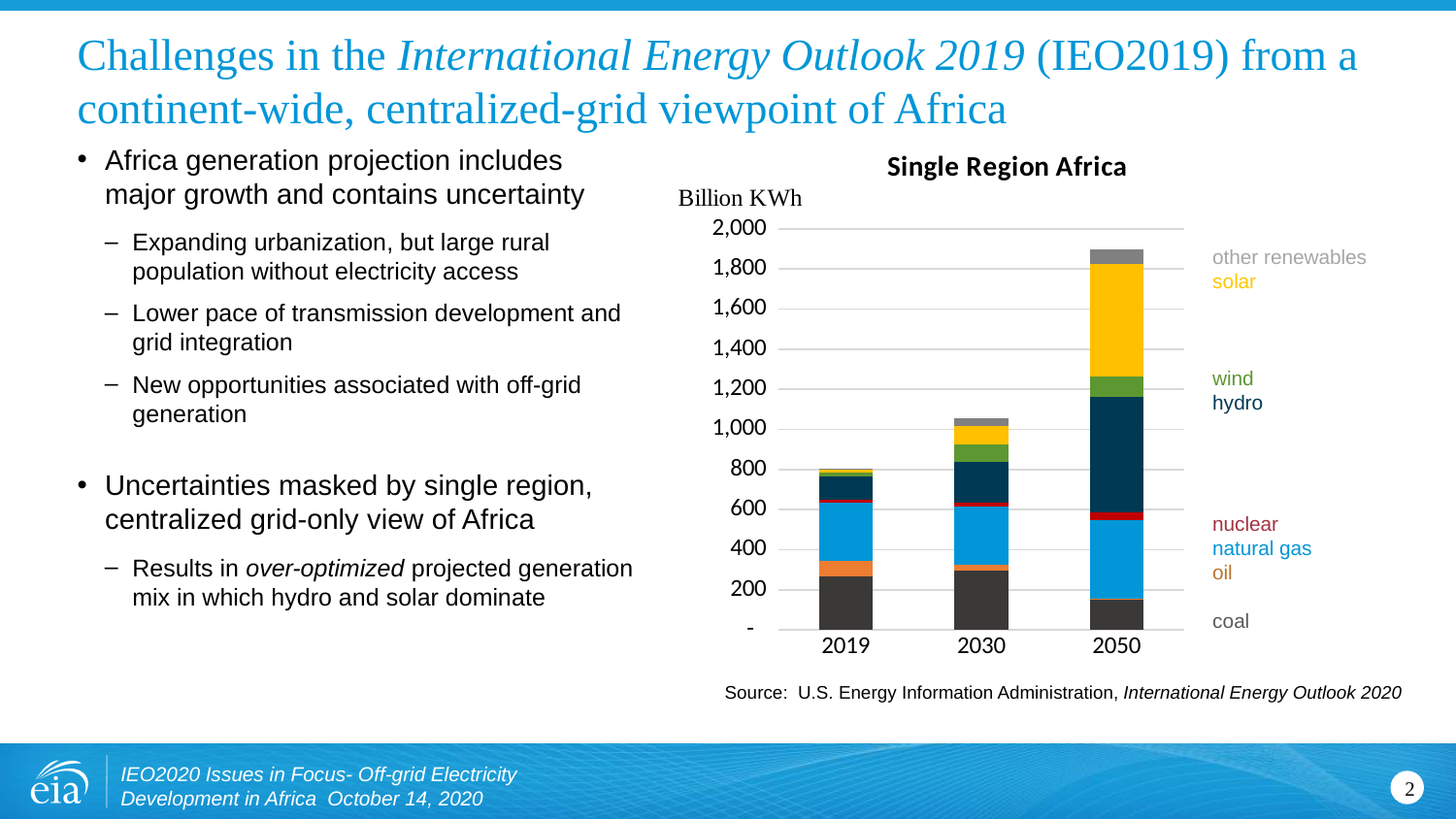
Which year has the highest total generation in the chart? 2050 Which year has the lowest total generation in the chart? 2019 Is the total generation for 2050 larger than the total for 2030? Yes What is the title of the chart? Single Region Africa How many years (categories) are shown on the x axis of the chart? 3 Is the total generation for 2030 greater or less than 800 billion KWh? greater How many generation sources (series) are labeled on the chart? 8 Does total generation rise or fall from 2019 to 2050 in the chart? rise Is the total generation for 2019 greater or less than 1,000 billion KWh? less What type of chart is shown on the slide? stacked bar chart What unit is shown on the chart's vertical axis? Billion KWh Is the total generation for 2050 greater or less than 1,800 billion KWh? greater